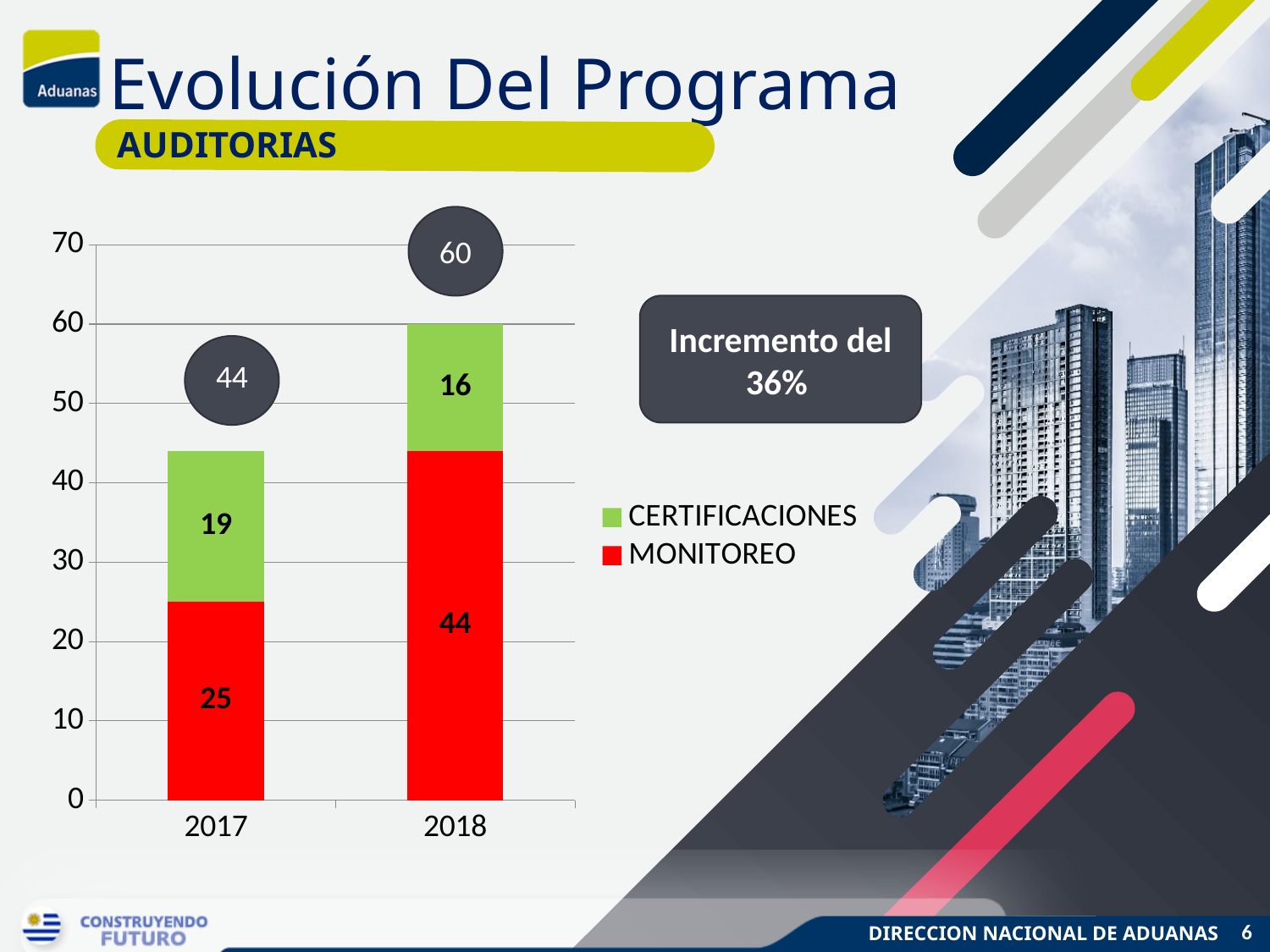
Which colour represents MONITOREO in the chart? Red What is the MONITOREO value for 2017? 25 Which year has the higher CERTIFICACIONES value, 2017 or 2018? 2017 How many series does the legend list? 2 What is the difference between the MONITOREO values for 2018 and 2017? 19 What is the CERTIFICACIONES value for 2017? 19 What is the total of the stacked bar for 2017? 44 What is the CERTIFICACIONES value for 2018? 16 How many categories are shown on the x axis? 2 What is the MONITOREO value for 2018? 44 What is the total of the stacked bar for 2018? 60 What kind of chart is shown on the slide? Stacked bar chart